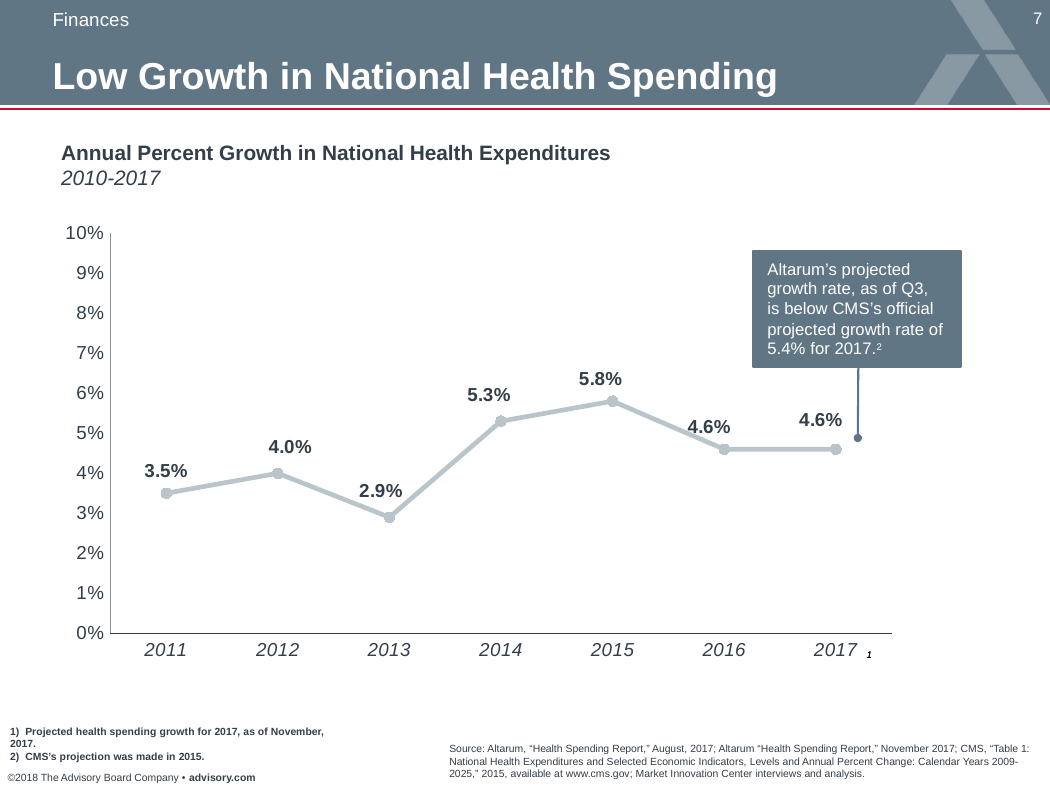
Which year has the lowest annual percent growth in national health expenditures? 2013 How many years are plotted on the chart? 7 Which year had higher growth, 2012 or 2014? 2014 What is the difference in percent growth between 2015 and 2016? 1.2% What is the annual percent growth in national health expenditures for 2013? 2.9% What kind of chart is shown on the slide? line chart Is the value for 2011 greater or less than 4%? less What is the annual percent growth in national health expenditures for 2015? 5.8% What is the title of the chart? Annual Percent Growth in National Health Expenditures What is the projected annual percent growth for 2017? 4.6% Which year has the highest annual percent growth in national health expenditures? 2015 Did the growth rate rise or fall from 2013 to 2015? rise